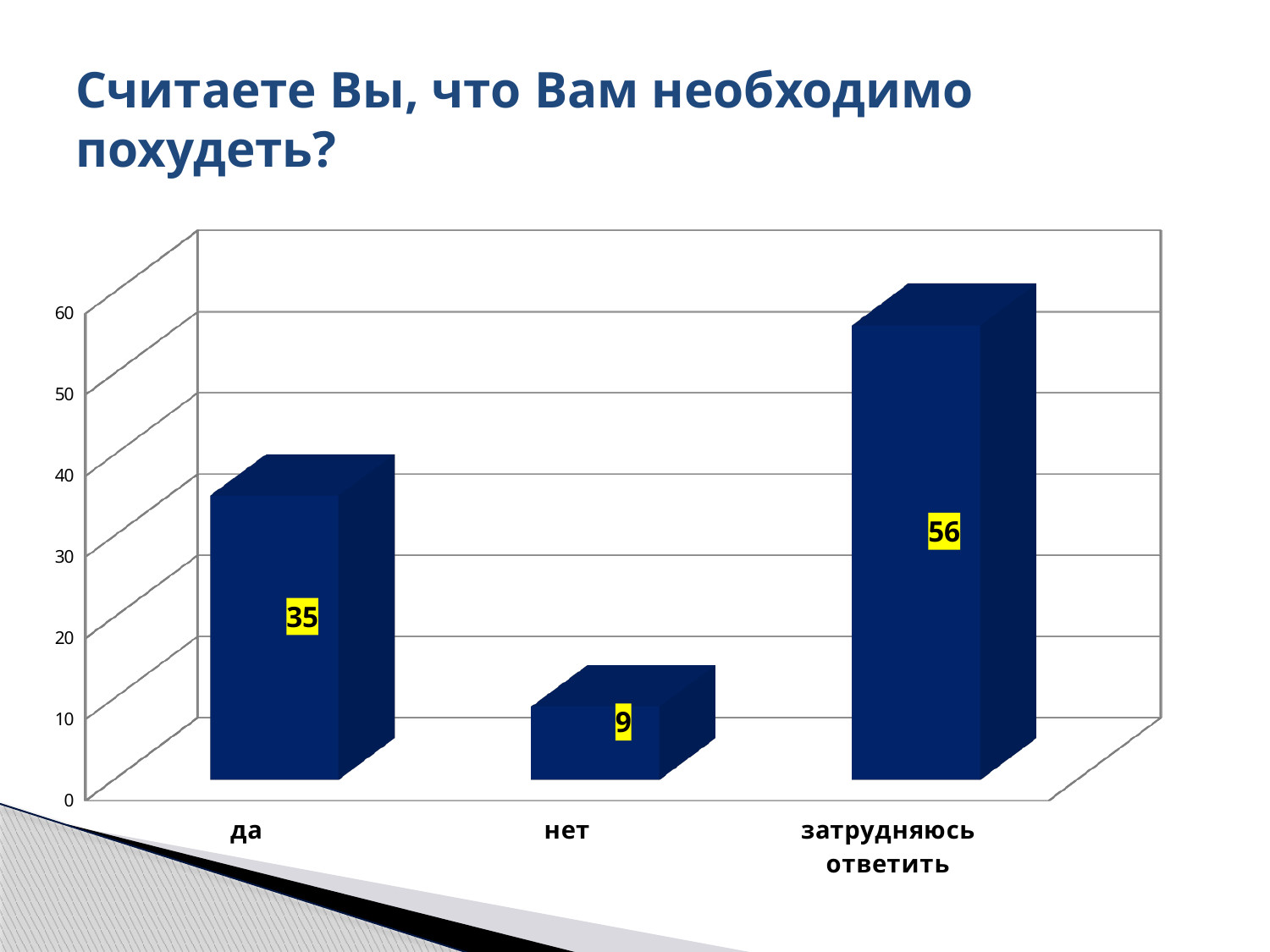
Which is larger, the value for "да" or the value for "нет"? да How many categories are shown on the chart? 3 What is the difference between the values for "да" and "нет"? 26 Which category has the highest value? затрудняюсь ответить What is the value for "нет"? 9 What kind of chart is shown on the slide? bar chart What is the title of the slide? Считаете Вы, что Вам необходимо похудеть? Which category has the lowest value? нет Is the value for "затрудняюсь ответить" greater or less than 50? greater What is the value for "да"? 35 What is the difference between the values for "затрудняюсь ответить" and "да"? 21 What is the value for "затрудняюсь ответить"? 56